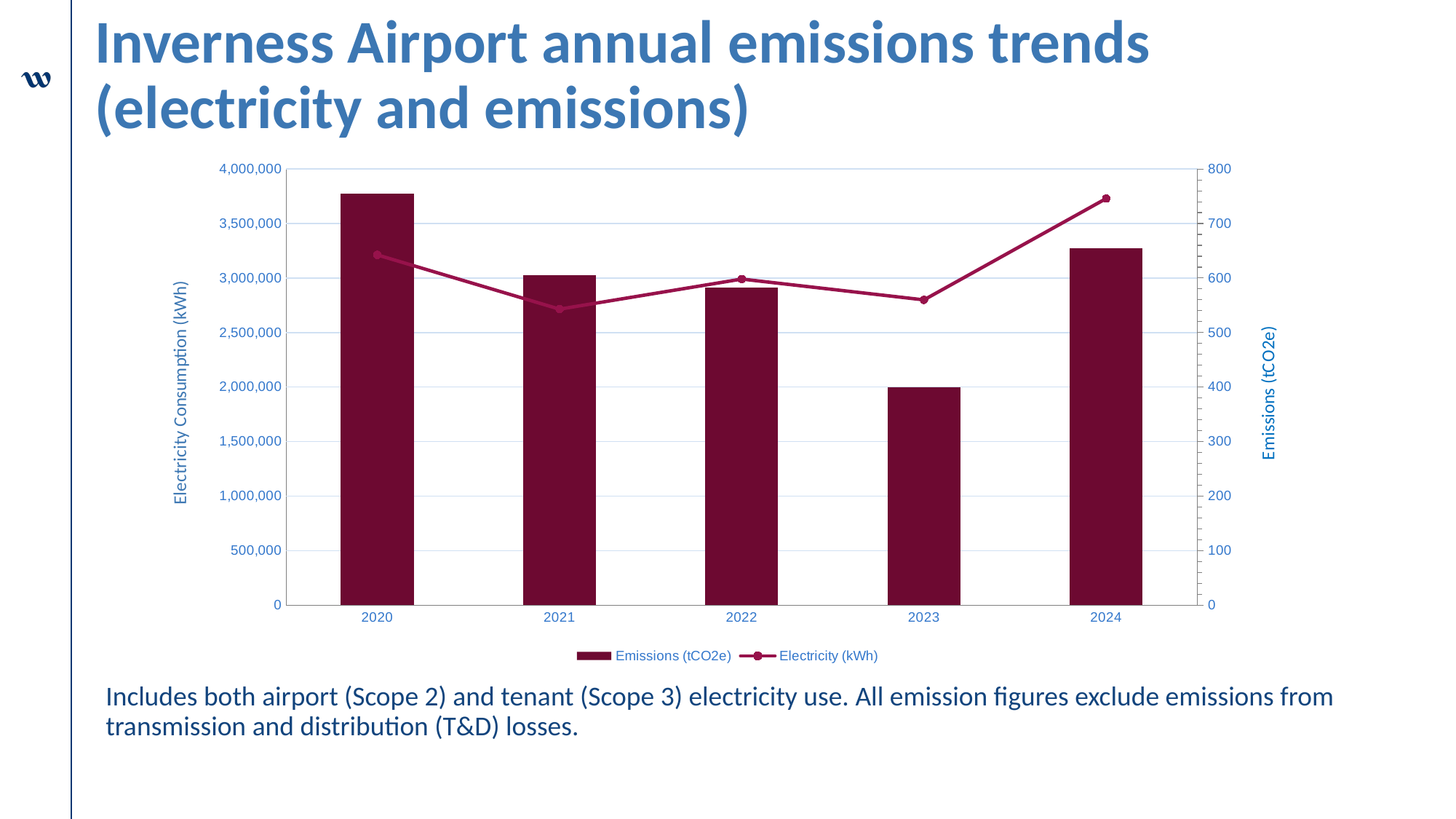
Which year has the highest Electricity (kWh) value on the line? 2024 How many series does the legend list? 2 Do the Emissions (tCO2e) bars rise or fall from 2020 to 2023? fall Is the Electricity (kWh) value for 2021 greater or less than 3,000,000? less Which is larger, the Electricity (kWh) value for 2024 or for 2020? 2024 Which year has the lowest Emissions (tCO2e) bar? 2023 Is the Electricity (kWh) value for 2024 greater or less than 3,500,000? greater Is the Emissions (tCO2e) value for 2020 greater or less than 700? greater Which year has the highest Emissions (tCO2e) bar? 2020 How many years are shown on the x axis? 5 What kind of chart is shown on the slide? A combination bar and line chart